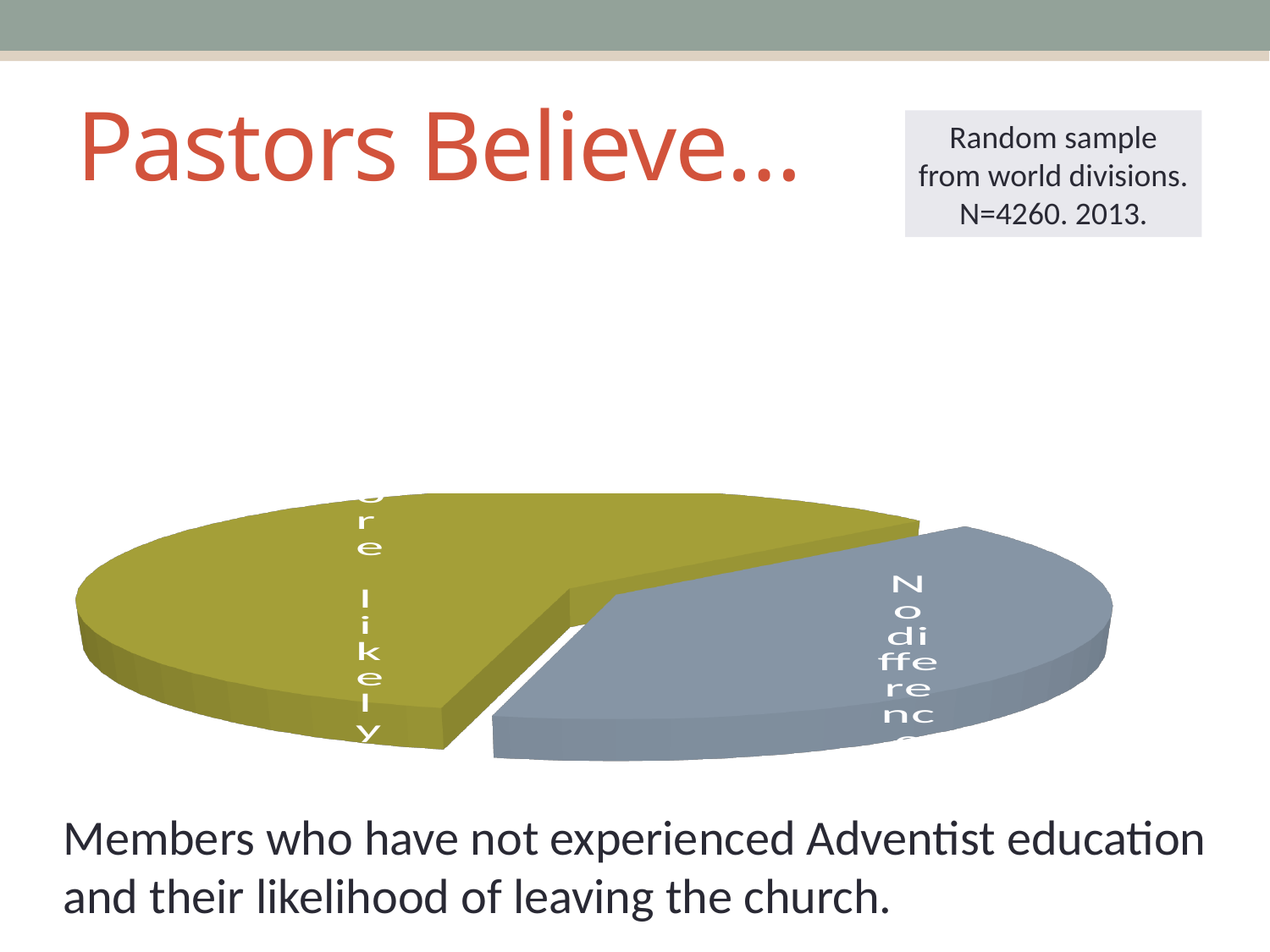
What is the title of the slide containing the pie chart? Pastors Believe… What kind of chart is shown on the slide? Pie chart How many slices does the pie chart have? 2 What colour is the "No difference" slice of the pie chart? Grey-blue Which slice of the pie chart is larger, the olive-green slice or the grey-blue "No difference" slice? The olive-green slice Which slice of the pie chart is the smallest? No difference